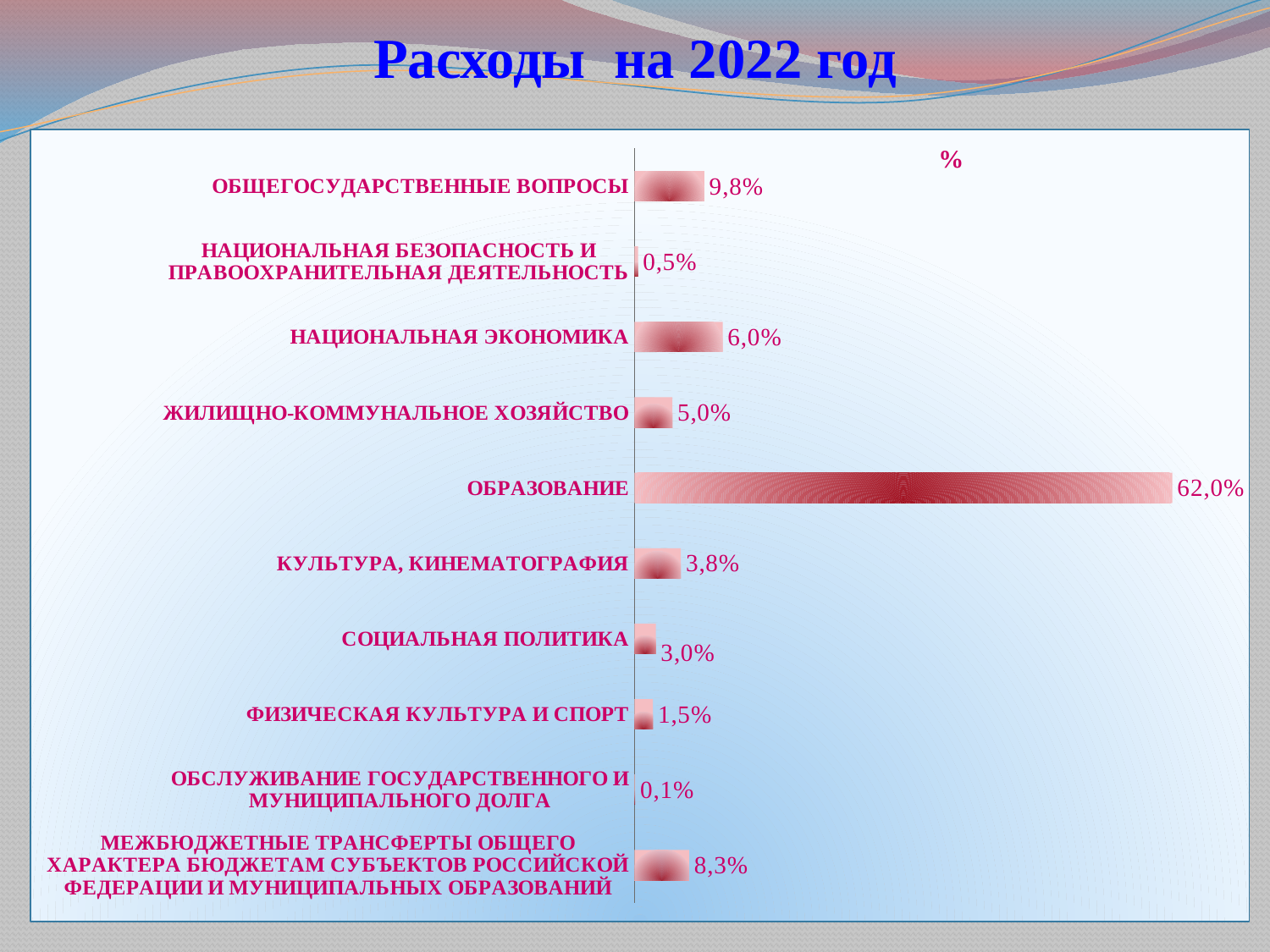
What is the value for ФИЗИЧЕСКАЯ КУЛЬТУРА И СПОРТ? 1,5% Which category has the lowest value? ОБСЛУЖИВАНИЕ ГОСУДАРСТВЕННОГО И МУНИЦИПАЛЬНОГО ДОЛГА Which category has the highest value? ОБРАЗОВАНИЕ What is the difference between the values for ОБРАЗОВАНИЕ and МЕЖБЮДЖЕТНЫЕ ТРАНСФЕРТЫ ОБЩЕГО ХАРАКТЕРА БЮДЖЕТАМ СУБЪЕКТОВ РОССИЙСКОЙ ФЕДЕРАЦИИ И МУНИЦИПАЛЬНЫХ ОБРАЗОВАНИЙ? 53,7% What is the value for НАЦИОНАЛЬНАЯ ЭКОНОМИКА? 6,0% What is the value for ОБРАЗОВАНИЕ? 62,0% What is the difference between the values for ОБЩЕГОСУДАРСТВЕННЫЕ ВОПРОСЫ and НАЦИОНАЛЬНАЯ ЭКОНОМИКА? 3,8% What is the value for ОБЩЕГОСУДАРСТВЕННЫЕ ВОПРОСЫ? 9,8% Which is larger: the value for ЖИЛИЩНО-КОММУНАЛЬНОЕ ХОЗЯЙСТВО or the value for КУЛЬТУРА, КИНЕМАТОГРАФИЯ? ЖИЛИЩНО-КОММУНАЛЬНОЕ ХОЗЯЙСТВО How many categories are shown in the chart? 10 What kind of chart is shown on the slide? bar chart What is the title of the slide? Расходы на 2022 год